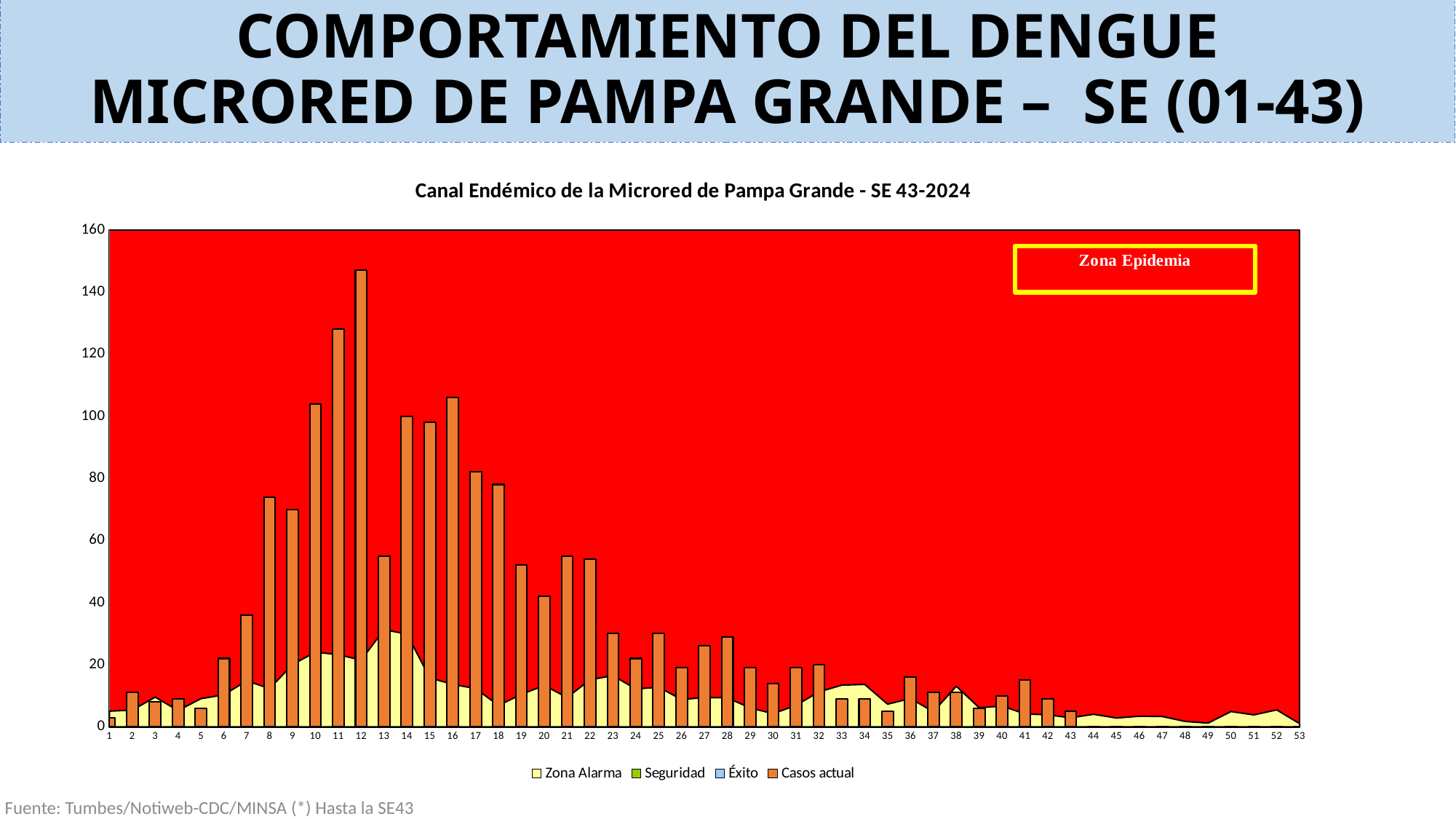
What label appears in the yellow-bordered box in the upper right of the plot area? Zona Epidemia Is the value for Casos actual in week 12 greater or less than 140? greater Is the value for Casos actual in week 43 greater or less than 20? less Do the Casos actual values generally rise or fall from week 12 to week 43? fall What type of chart is shown on the slide? combination bar and area chart Which week has the highest value for Casos actual? 12 Is the value for Casos actual in week 10 greater or less than 100? greater Which is larger, the Casos actual value for week 14 or for week 17? week 14 What is the title of the chart? Canal Endémico de la Microred de Pampa Grande - SE 43-2024 How many week categories are shown along the x axis? 53 How many entries does the chart legend list? 4